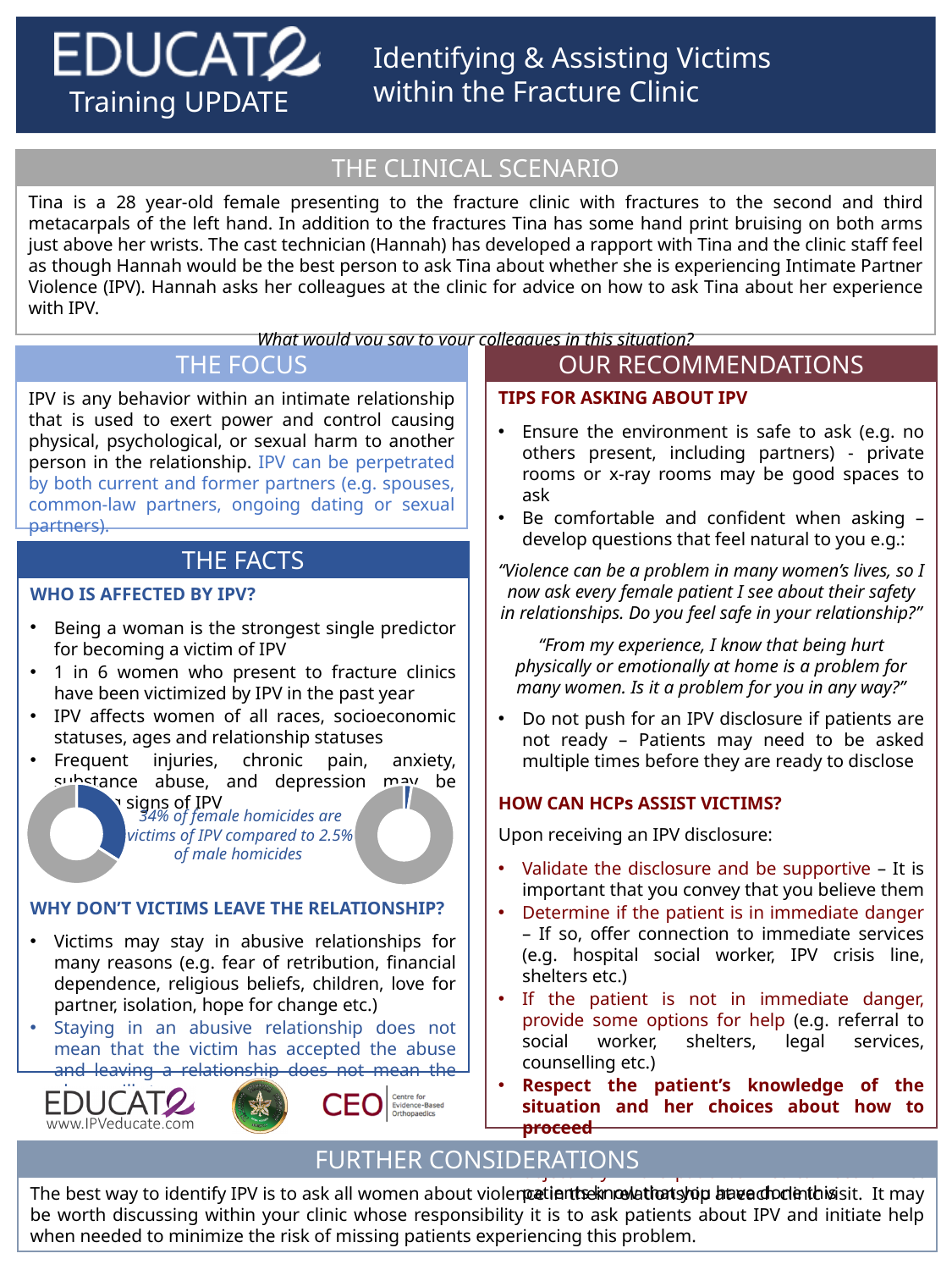
Does the blue slice in the left donut chart represent more or less than half of the chart? less What kind of chart are the two small charts in THE FACTS section of the slide? donut (pie) chart Based on the caption between the donut charts, what is the difference in percentage points between female homicides (34%) and male homicides (2.5%) that are victims of IPV? 31.5 What colour is the larger portion of each donut chart in THE FACTS section? grey How many donut charts are shown in THE FACTS section? 2 Based on the donut charts and their caption, which group has the higher share of homicide victims who are victims of IPV, female or male? female Which of the two donut charts in THE FACTS section has the larger blue slice, the left one or the right one? left According to the caption between the two donut charts, what percentage of male homicides are victims of IPV? 2.5% Under which section heading of the slide do the two donut charts appear? THE FACTS According to the caption between the two donut charts, what percentage of female homicides are victims of IPV? 34%